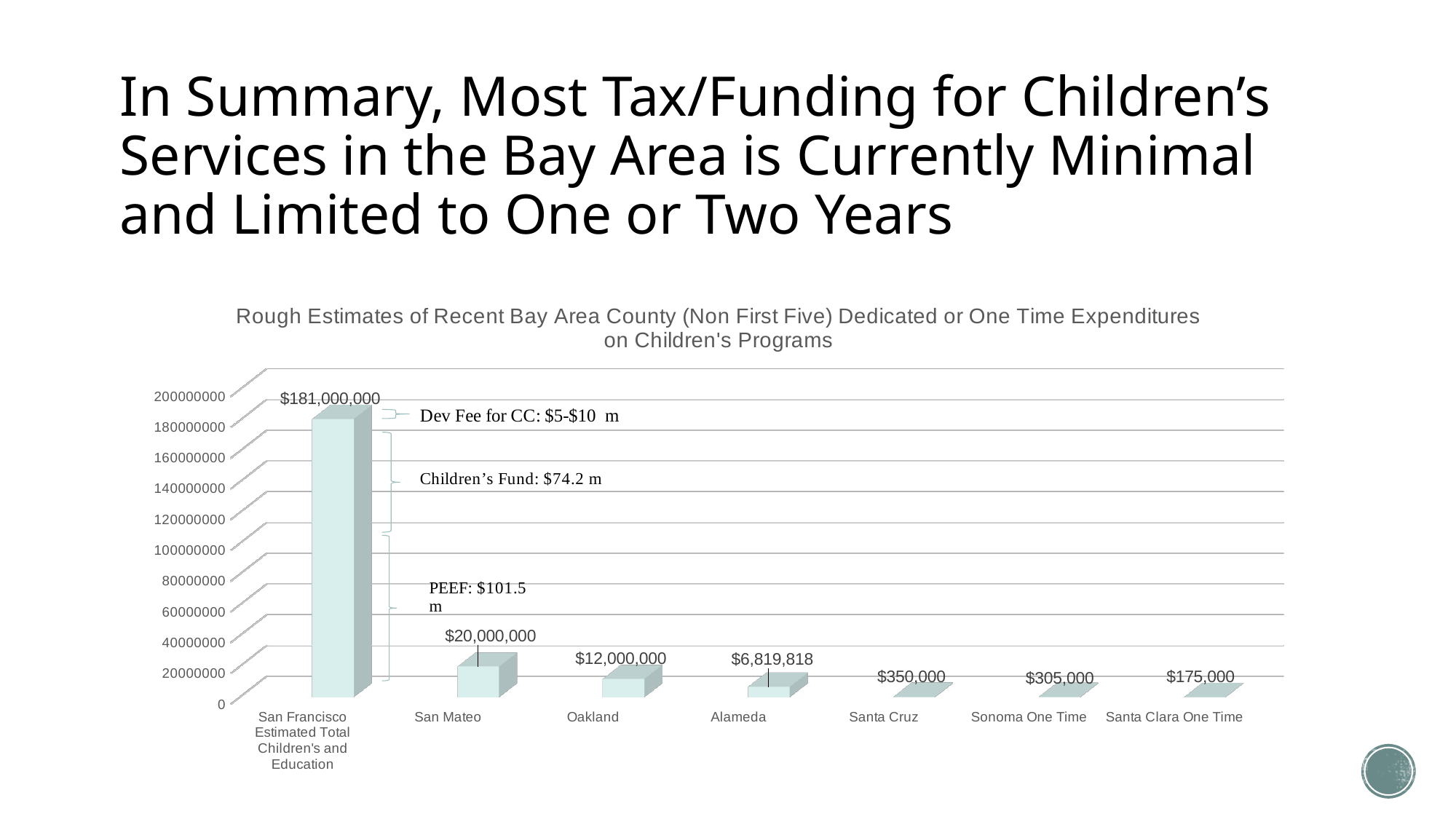
What is the value for Alameda? $6,819,818 How many categories are shown on the x axis? 7 What is the value for Santa Cruz? $350,000 What is the title of the chart? Rough Estimates of Recent Bay Area County (Non First Five) Dedicated or One Time Expenditures on Children's Programs Is the value for Oakland greater or less than 20000000? less What is the difference between the values for San Mateo and Oakland? $8,000,000 What kind of chart is shown on the slide? bar chart What is the value for San Mateo? $20,000,000 Which is larger, the value for Santa Cruz or the value for Sonoma One Time? Santa Cruz Which category has the lowest value? Santa Clara One Time What is the value for Sonoma One Time? $305,000 Which category has the highest value? San Francisco Estimated Total Children's and Education